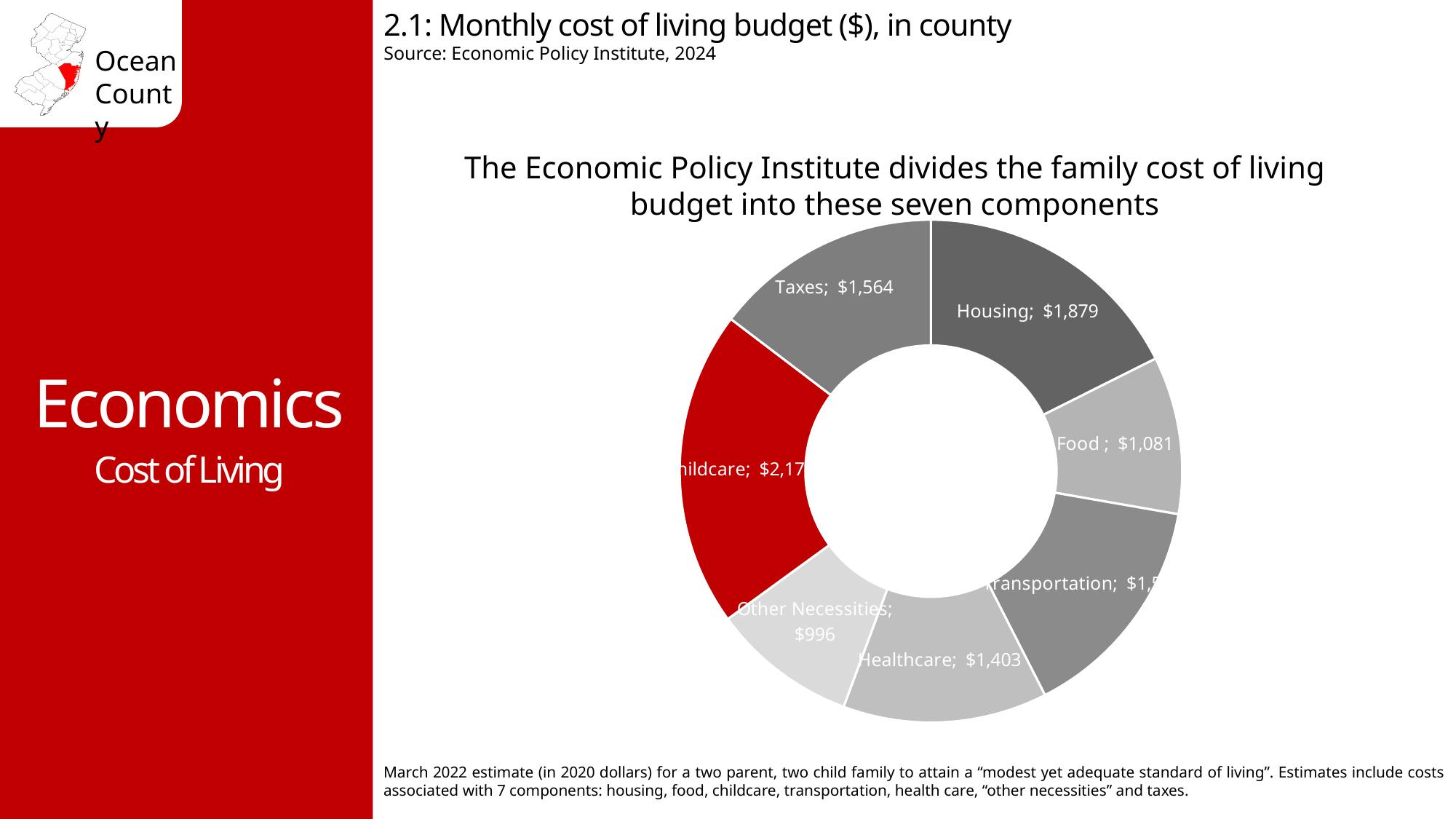
Which component has the largest share of the monthly cost of living budget? Childcare What is the monthly cost for Food? $1,081 What type of chart is shown on the slide? Doughnut (pie) chart What is the monthly cost for Taxes? $1,564 What is the difference between the Housing and Taxes monthly costs? $315 What is the monthly cost for Healthcare? $1,403 Which is larger, the monthly cost for Taxes or for Healthcare? Taxes What is the monthly cost for Other Necessities? $996 What is the monthly cost for Housing? $1,879 Which component is shown in red on the chart? Childcare How many components does the chart divide the cost of living budget into? 7 Which component has the smallest monthly cost? Other Necessities